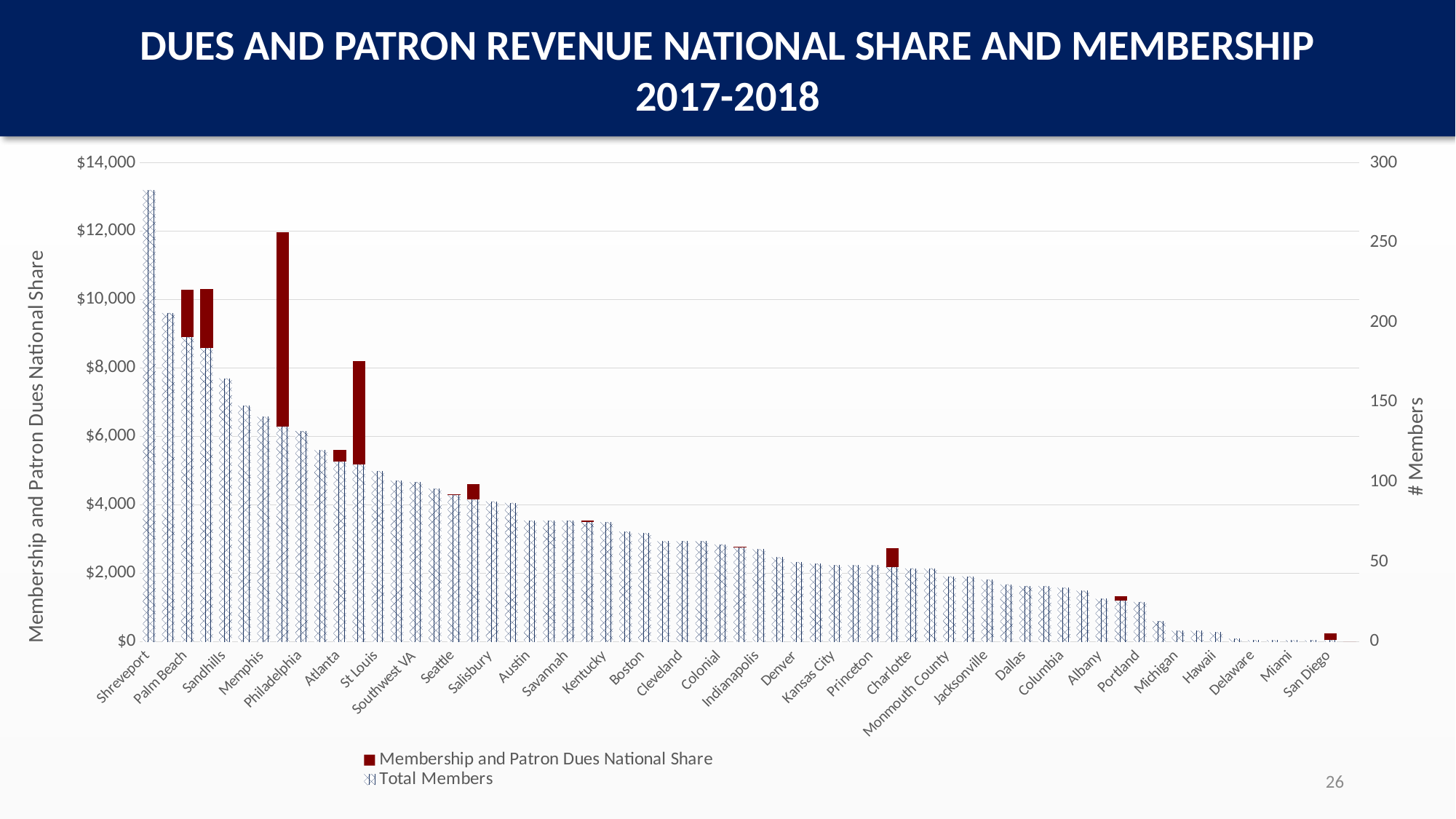
Do the Total Members values generally rise or fall moving from left to right along the x axis? fall Is the Total Members value for Shreveport greater or less than 250? greater What is the label of the right-hand vertical axis? # Members Which has more Total Members, Shreveport or Palm Beach? Shreveport How many series does the legend list? 2 Which category has the highest Total Members? Shreveport What kind of chart is shown on the slide? bar chart Is the Membership and Patron Dues National Share for Charlotte greater or less than $4,000? less